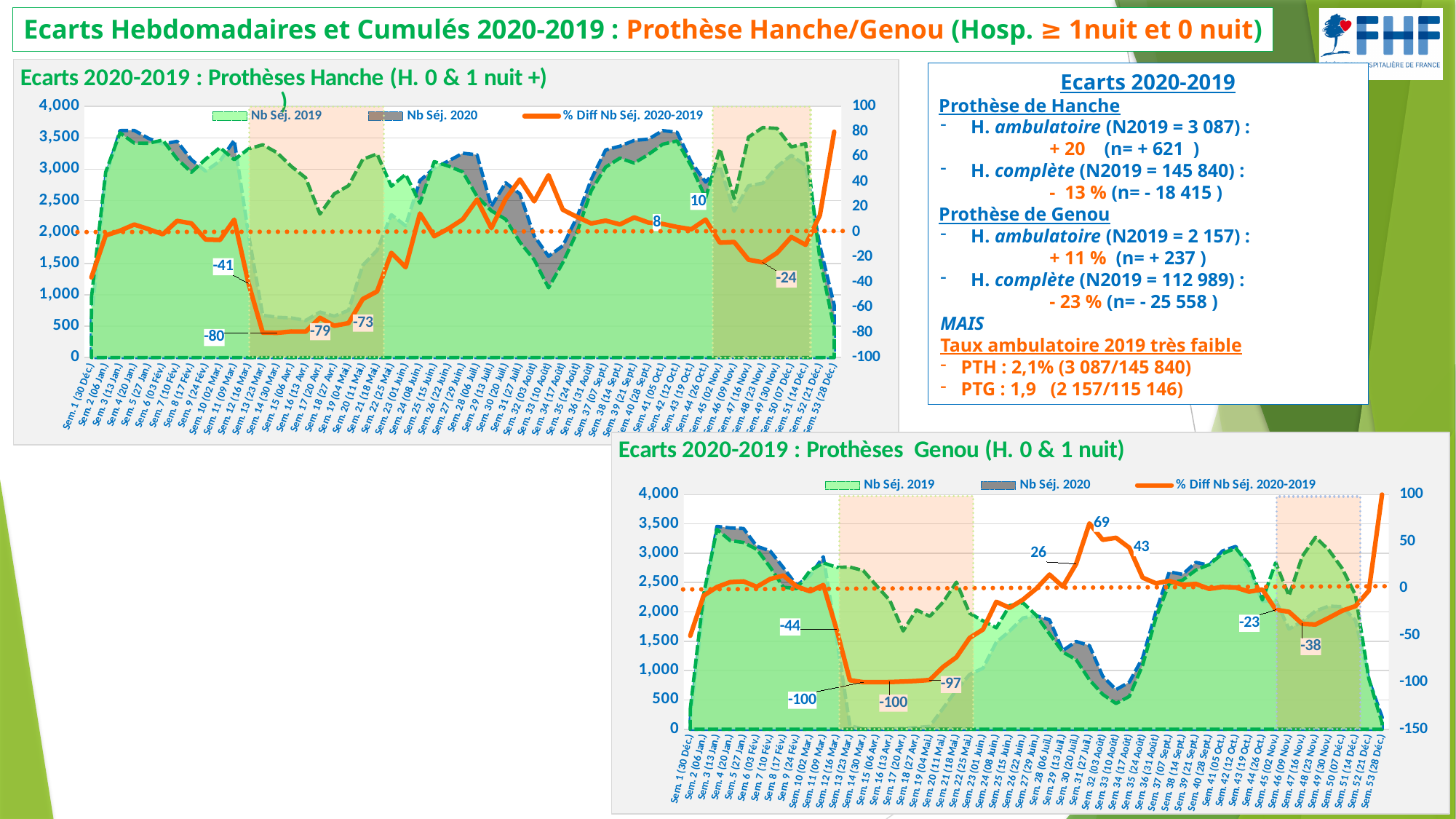
In the Prothèses Genou chart, what is the labelled value of the % Diff line at its peak around Sem. 32? 69 In the Prothèses Genou chart, what kind of chart element is used to plot the % Diff Nb Séj. 2020-2019 series? a line In the Prothèses Genou chart, what is the lowest labelled value on the % Diff Nb Séj. 2020-2019 line? -100 In the Prothèses Genou chart, what is the difference between the labelled values 69 and 43 on the % Diff line? 26 In the Prothèses Genou chart, what is the highest labelled value on the % Diff Nb Séj. 2020-2019 line? 69 What is the title of the chart at the bottom right of the slide? Ecarts 2020-2019 : Prothèses Genou (H. 0 & 1 nuit) In the Prothèses Hanche chart, what is the lowest labelled value on the % Diff Nb Séj. 2020-2019 line? -80 In the chart titled "Ecarts 2020-2019 : Prothèses Genou (H. 0 & 1 nuit)", how many series does the legend list? 3 In the Prothèses Genou chart, which of the two labelled values in the November-December shaded region, -23 or -38, is larger? -23 In the chart titled "Ecarts 2020-2019 : Prothèses Hanche (H. 0 & 1 nuit +)", how many series does the legend list? 3 In the Prothèses Hanche chart, how many weeks (Sem.) are shown on the x axis? 53 In the Prothèses Hanche chart, what is the highest labelled value on the % Diff Nb Séj. 2020-2019 line? 10